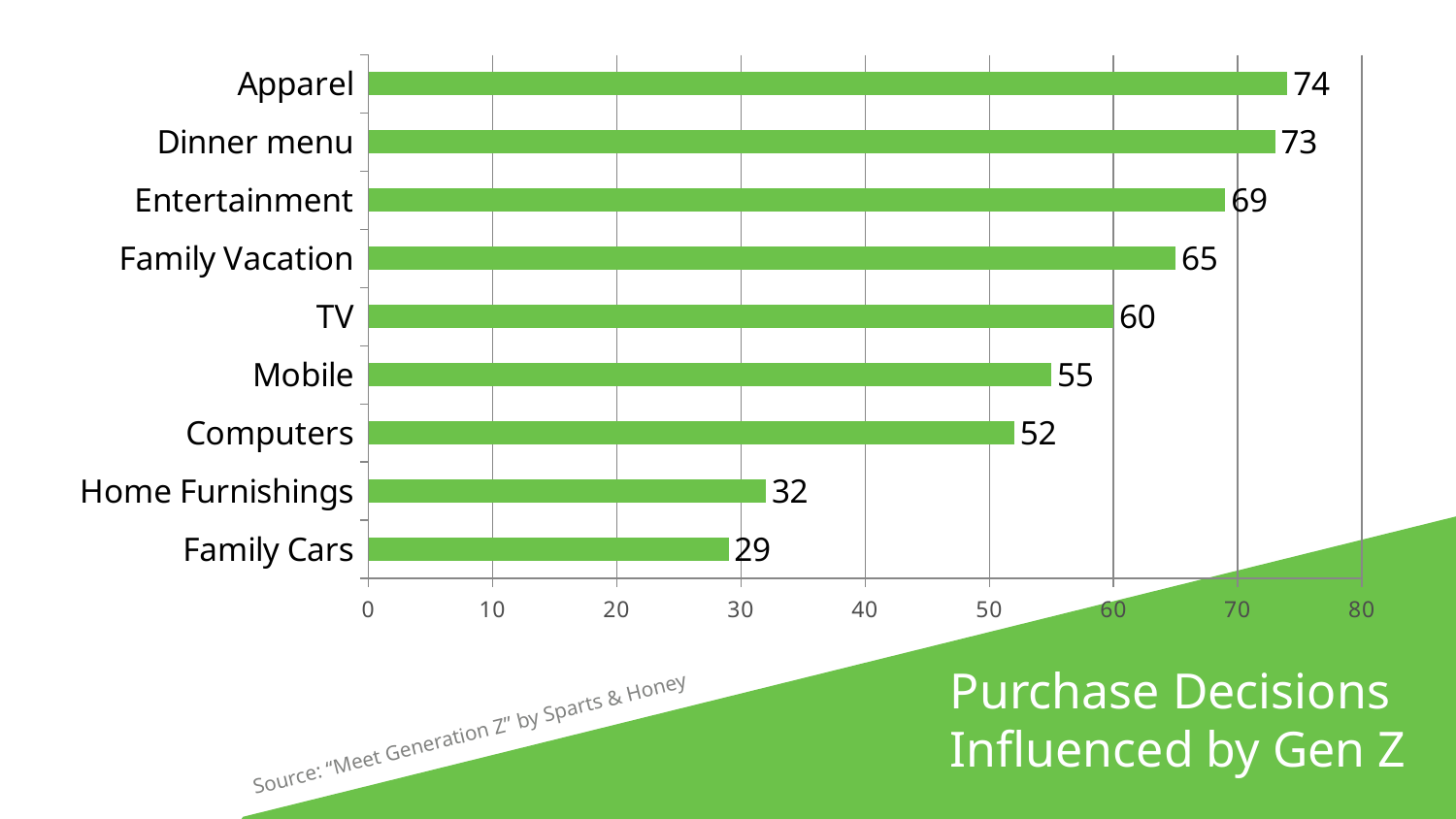
Which is larger, the value for Computers or the value for Home Furnishings? Computers What is the difference between the values for TV and Mobile? 5 Which category has the highest value? Apparel What is the value for Family Vacation? 65 What kind of chart is shown on the slide? Bar chart What is the difference between the values for Entertainment and Family Cars? 40 What is the title shown on the slide for this chart? Purchase Decisions Influenced by Gen Z How many categories are shown in the chart? 9 What is the value for Apparel? 74 Is the value for Dinner menu greater or less than 70? greater Which category has the lowest value? Family Cars What is the value for Home Furnishings? 32